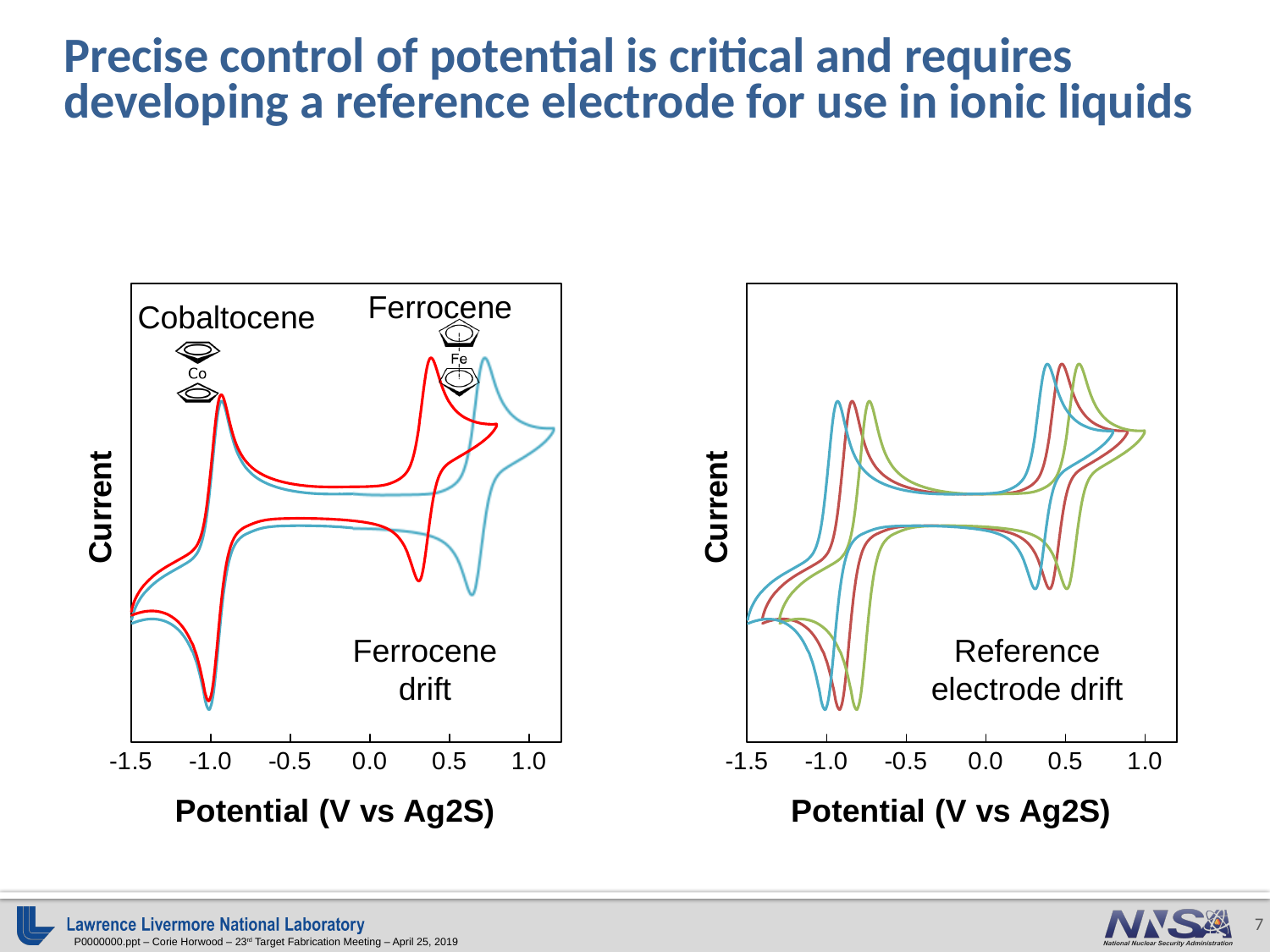
In the right chart, are the peaks on the right-hand side of the curves at potentials greater or less than 0.0? greater In the left chart, is the potential of the ferrocene peak greater or less than 0.0? greater What is the y-axis label of the right chart? Current How many curves are plotted in the left chart? 2 What is the x-axis label of the left chart? Potential (V vs Ag2S) In the left chart, is the potential of the cobaltocene peak greater or less than -0.5? less What kind of chart is the left chart on the slide? line chart What kind of chart is the right chart on the slide? line chart How many curves are plotted in the right chart? 3